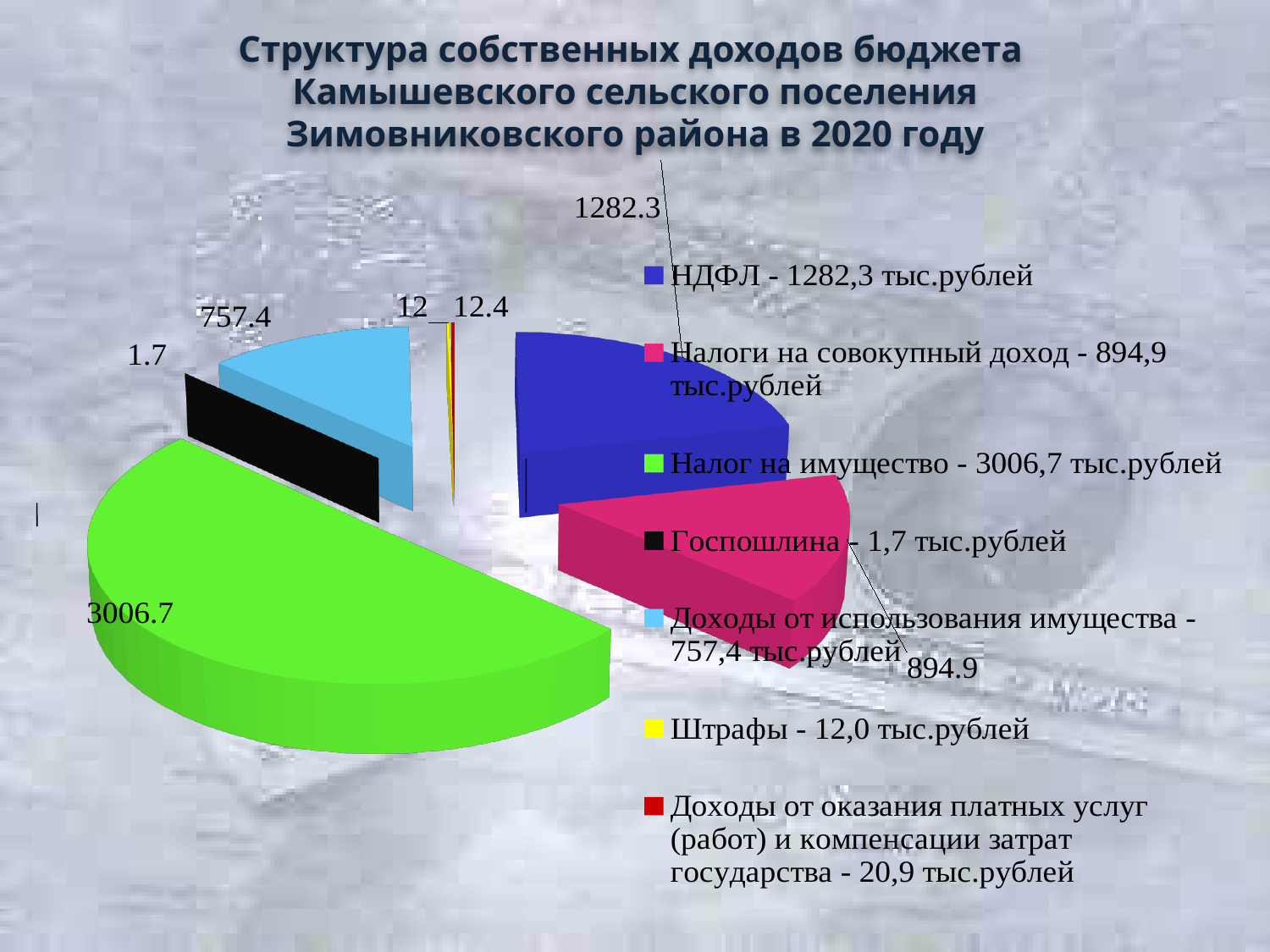
Which is larger: the slice for НДФЛ or the slice for Доходы от использования имущества? НДФЛ Which category has the largest slice in the pie chart? Налог на имущество What value is labelled on the slice for Налоги на совокупный доход? 894.9 Which category has the smallest slice in the pie chart? Госпошлина What is the difference between the labelled values for Налог на имущество (3006.7) and НДФЛ (1282.3)? 1724.4 What colour is the slice for Налог на имущество in the pie chart? green What value is labelled on the slice for НДФЛ? 1282.3 What kind of chart is shown on the slide? pie chart What value is labelled on the slice for Доходы от использования имущества? 757.4 What is the difference between the labelled values for НДФЛ (1282.3) and Налоги на совокупный доход (894.9)? 387.4 How many categories does the legend of the pie chart list? 7 What value is labelled on the slice for Госпошлина? 1.7